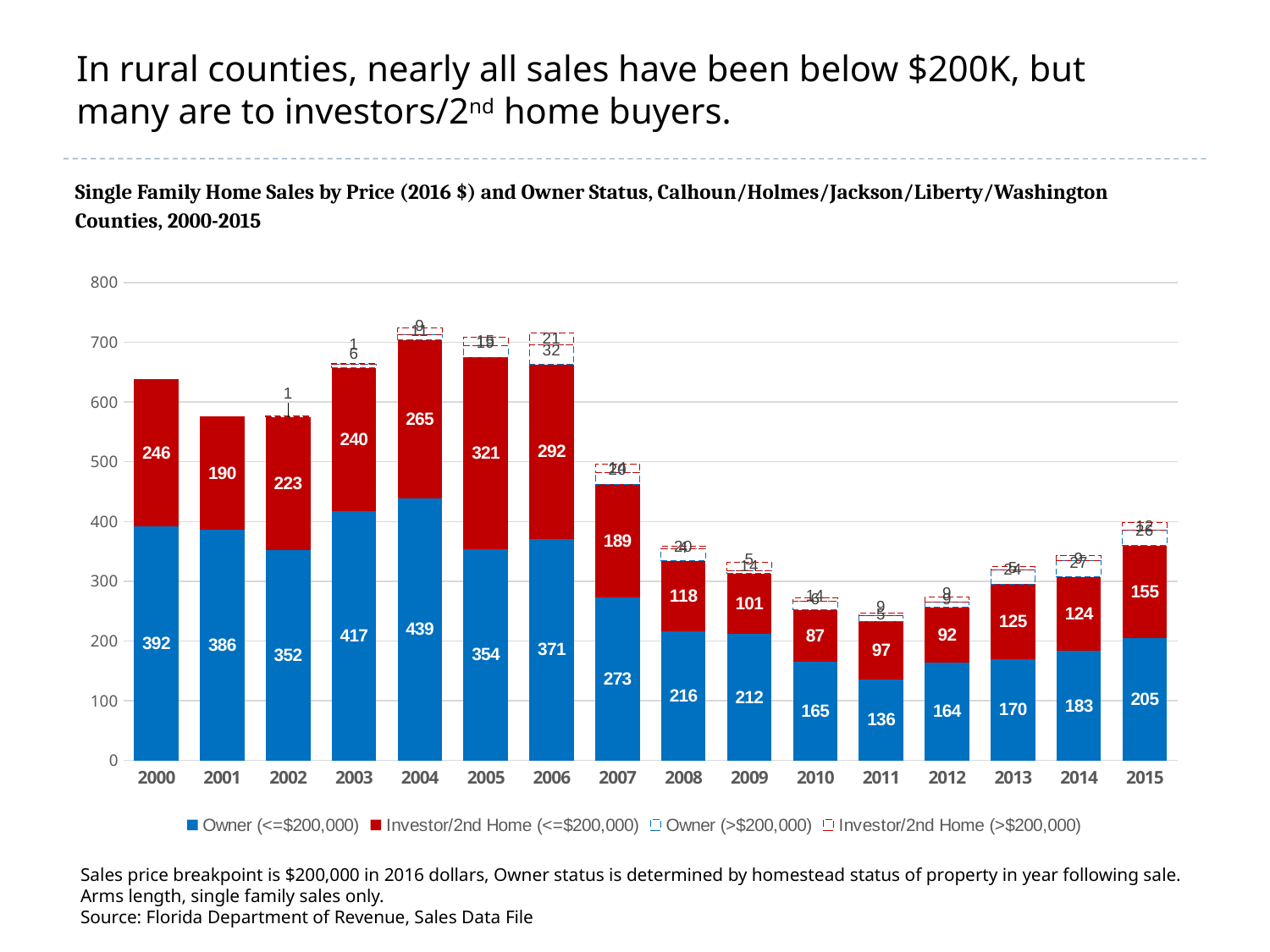
How many series does the legend list? 4 What is the value for Investor/2nd Home (<=$200,000) in 2005? 321 What is the difference between the Owner (<=$200,000) values for 2004 and 2011? 303 Is the total height of the 2000 bar greater or less than 600? greater Which year has the lowest value for Investor/2nd Home (<=$200,000)? 2010 How many years are shown on the x axis? 16 What kind of chart is shown on the slide? Stacked bar chart Which year has the highest value for Owner (<=$200,000)? 2004 Do the Owner (<=$200,000) values rise or fall from 2004 to 2011? Fall What is the value for Owner (<=$200,000) in 2004? 439 What is the value for Owner (<=$200,000) in 2011? 136 Which is larger, the Investor/2nd Home (<=$200,000) value for 2006 or for 2007? 2006